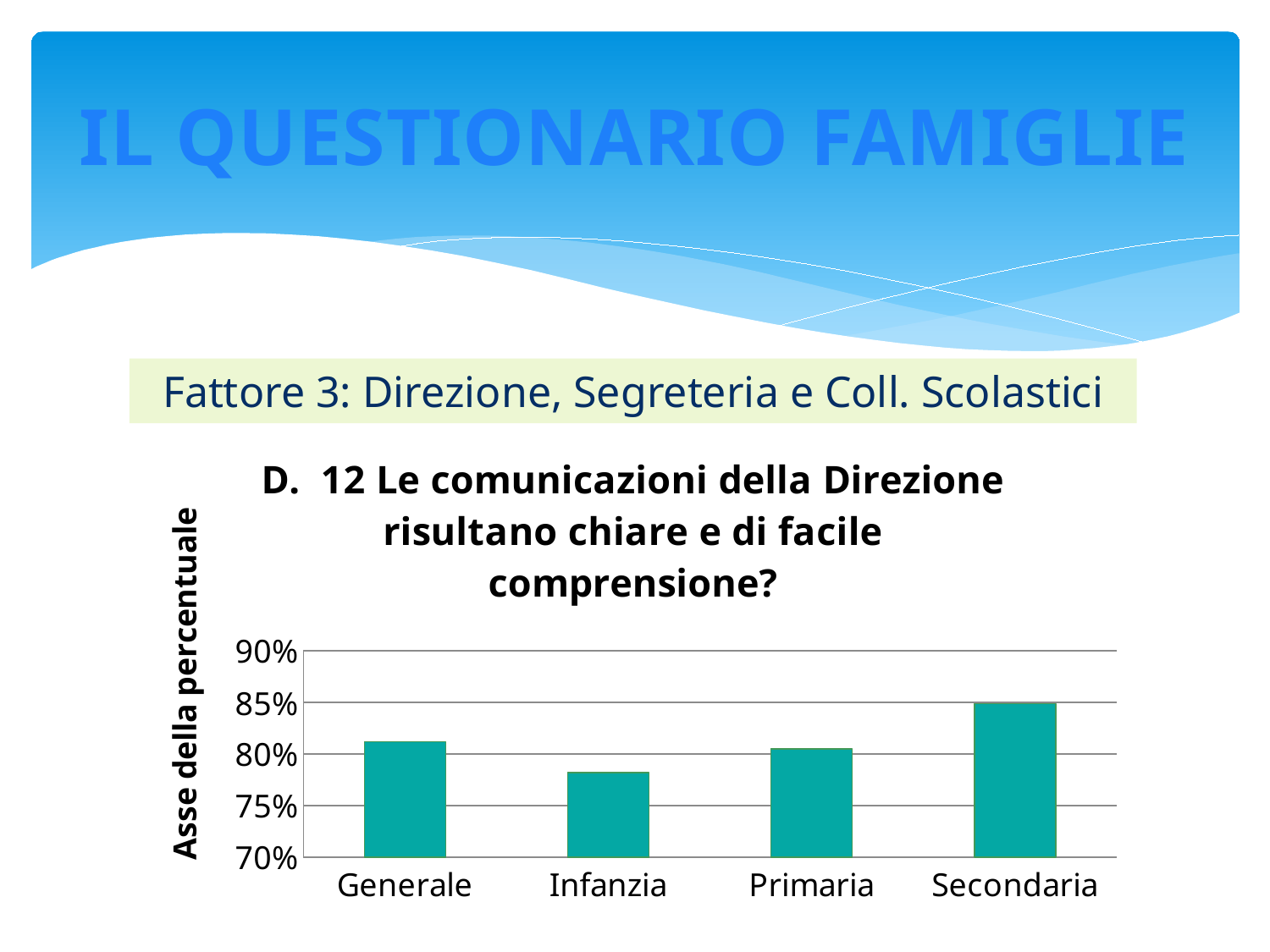
Which category has the highest value in the chart? Secondaria What is the label of the vertical axis of the chart? Asse della percentuale Is the value for Infanzia greater or less than 80%? less Is the value for Generale greater or less than 80%? greater What is the title of the chart? D. 12 Le comunicazioni della Direzione risultano chiare e di facile comprensione? What kind of chart is shown on the slide? bar chart Which has a larger value, Generale or Infanzia? Generale Is the value for Secondaria greater or less than 80%? greater Which has a larger value, Secondaria or Primaria? Secondaria Which category has the lowest value in the chart? Infanzia How many categories are shown on the x axis of the chart? 4